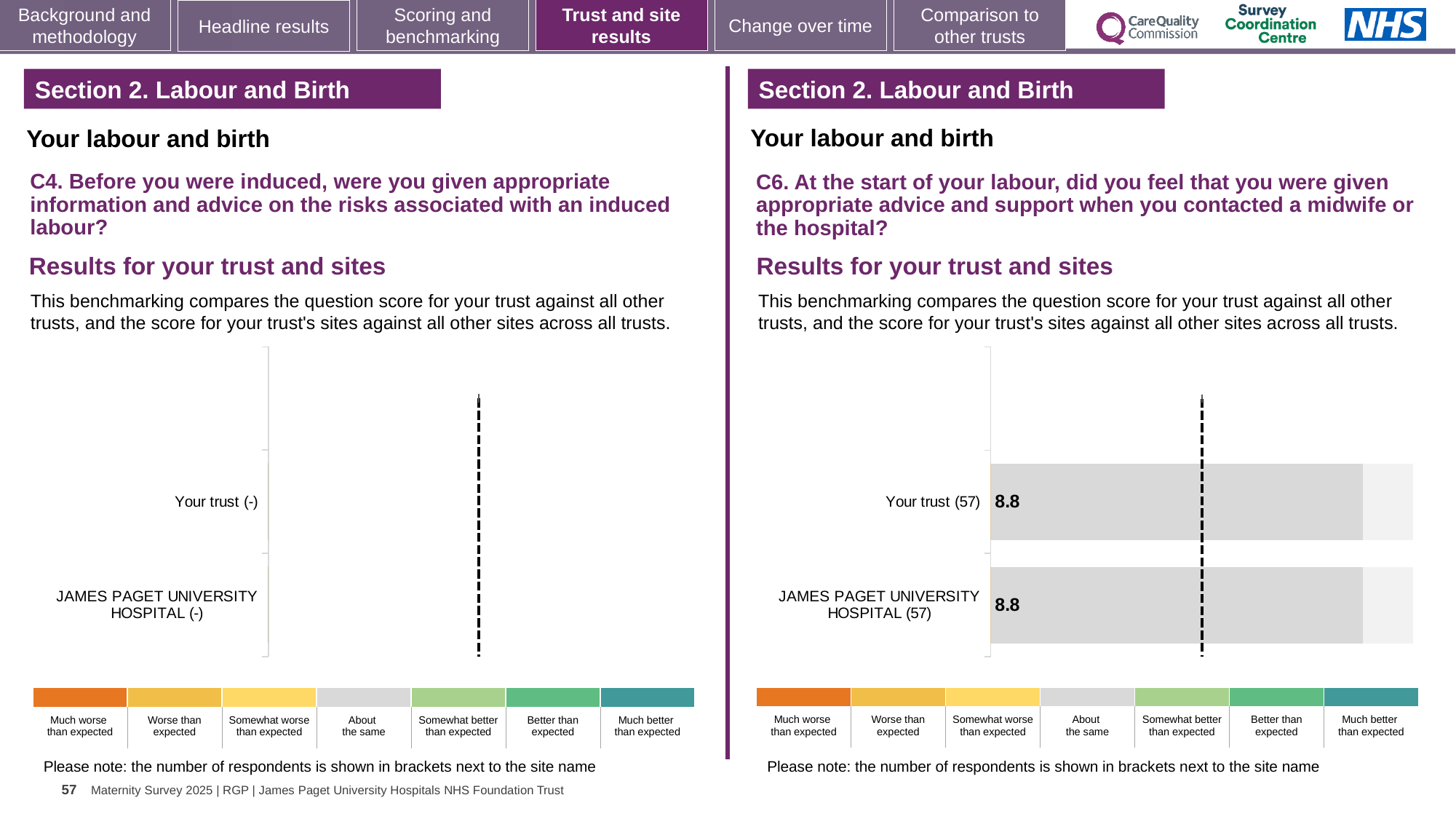
In the C6 chart on the right, how many respondents are shown in brackets for James Paget University Hospital? 57 In the C4 chart on the left, what is shown in brackets next to Your trust? - In the C6 chart on the right, what is the score for Your trust? 8.8 How many categories are plotted in the C6 chart on the right? 2 What type of chart is the C6 chart on the right? bar chart How many benchmarking categories are shown in the colour key below each chart? 7 In the C6 chart on the right, is the score for Your trust higher, lower, or the same as the score for James Paget University Hospital? the same In the C6 chart on the right, how many respondents are shown in brackets for Your trust? 57 How many categories are listed in the C4 chart on the left? 2 In the C6 chart on the right, what is the difference between the score for Your trust and the score for James Paget University Hospital? 0.0 In the C6 chart on the right, what is the score for James Paget University Hospital? 8.8 According to the colour key, which benchmarking category do the grey bars in the C6 chart on the right represent? About the same